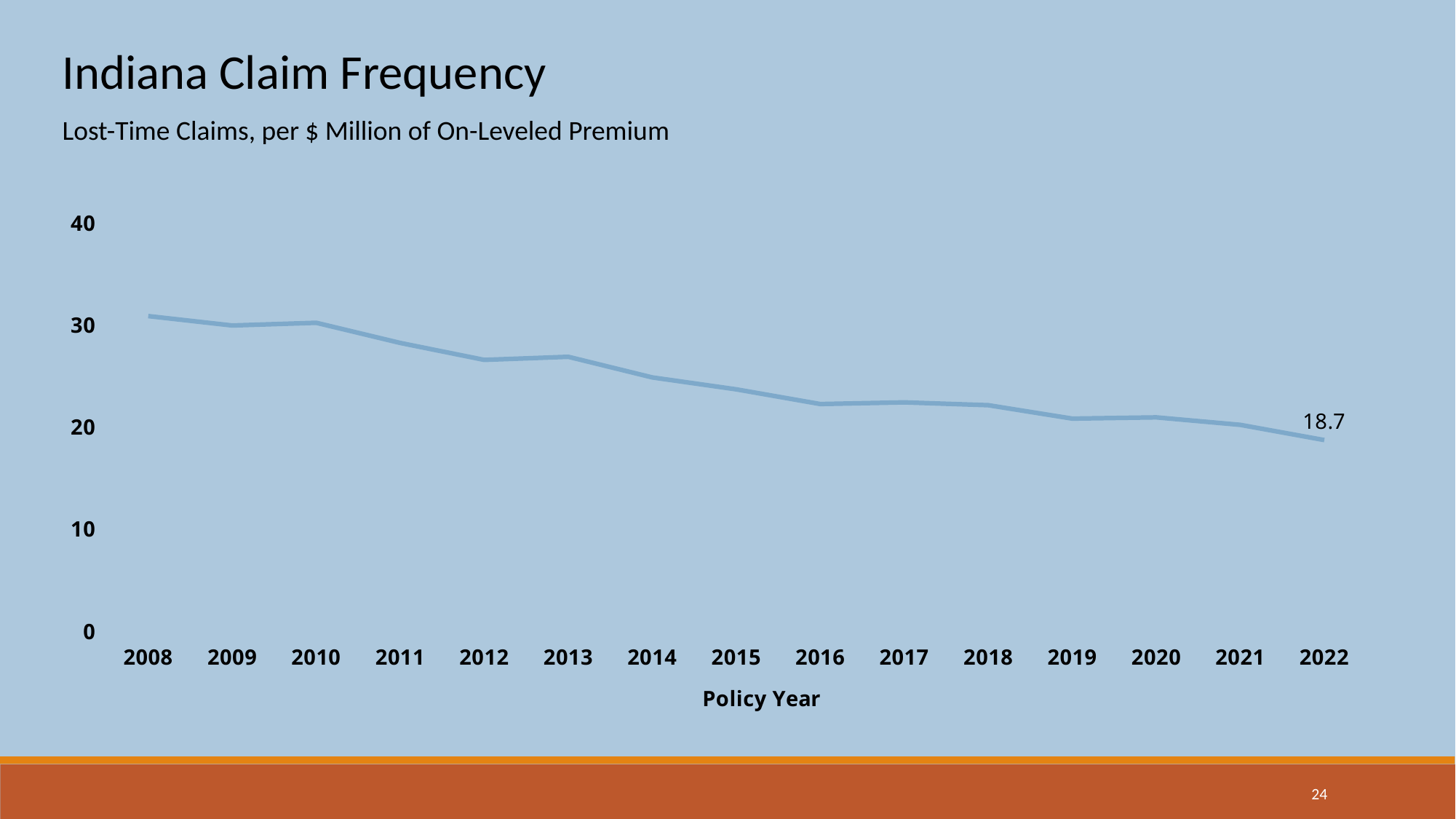
How many policy years are plotted on the chart? 15 Is the value for 2012 greater or less than 30? less What is the claim frequency value shown for policy year 2022? 18.7 What is the label of the x axis? Policy Year What kind of chart is shown on the slide? line chart Is the value for 2008 greater or less than 30? greater Is the value for 2016 greater or less than 20? greater Which policy year has the highest claim frequency? 2008 Do the values generally rise or fall from 2008 to 2022? fall Which policy year has the lowest claim frequency? 2022 Which is larger, the value for 2010 or the value for 2014? 2010